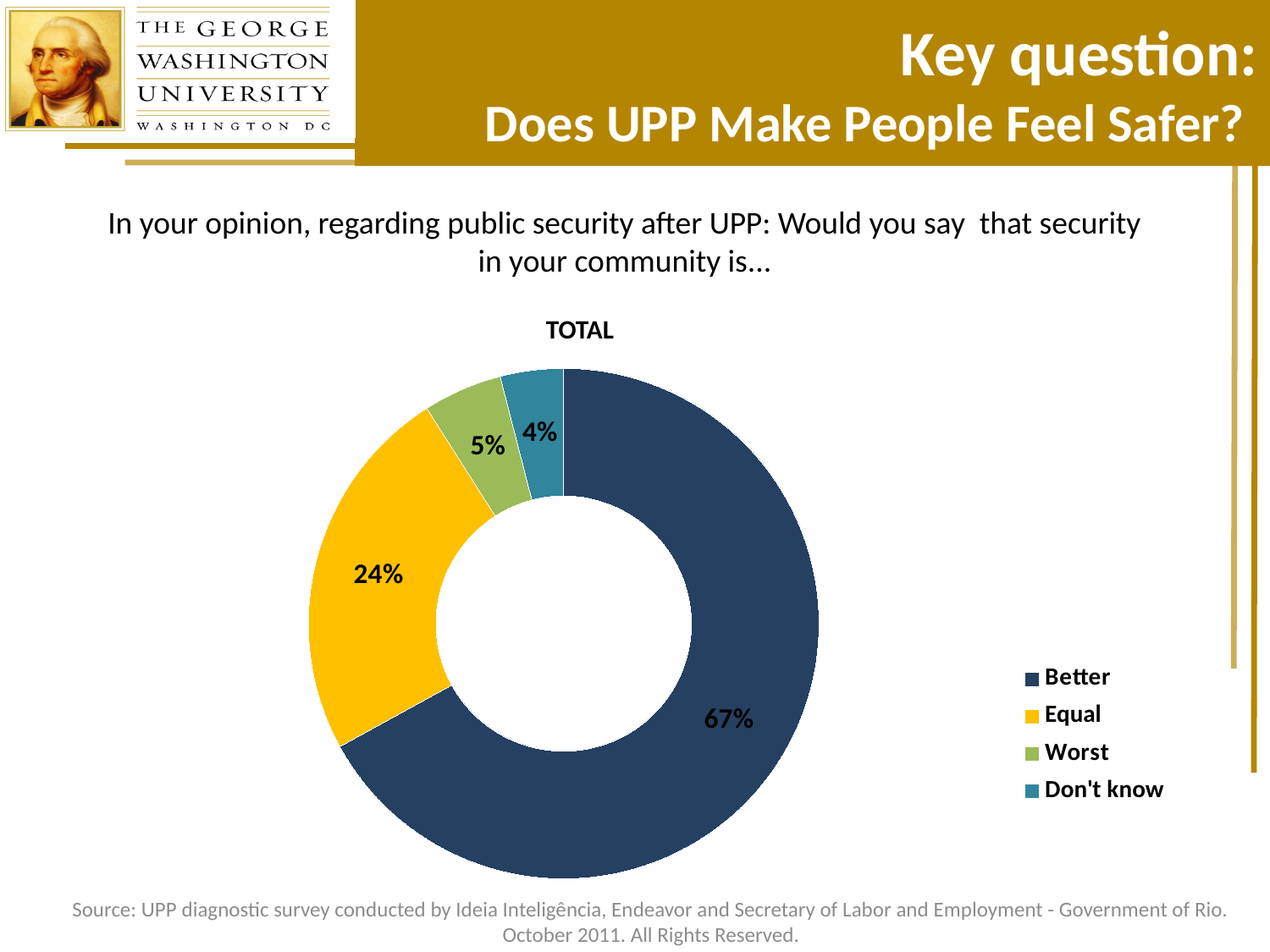
What colour represents the Equal category in the chart? Yellow What percentage of respondents said security in their community is Better? 67% Which response category has the smallest share of the chart? Don't know What is the title of the chart? TOTAL What percentage of respondents said security in their community is Worst? 5% What percentage of respondents answered Don't know? 4% What kind of chart is shown on the slide? Pie chart (doughnut) Which is larger, the share for Equal or the share for Worst? Equal How many response categories are shown in the chart? 4 What is the difference in percentage points between the Better and Equal shares? 43 What percentage of respondents said security in their community is Equal? 24% Which response category has the largest share of the chart? Better